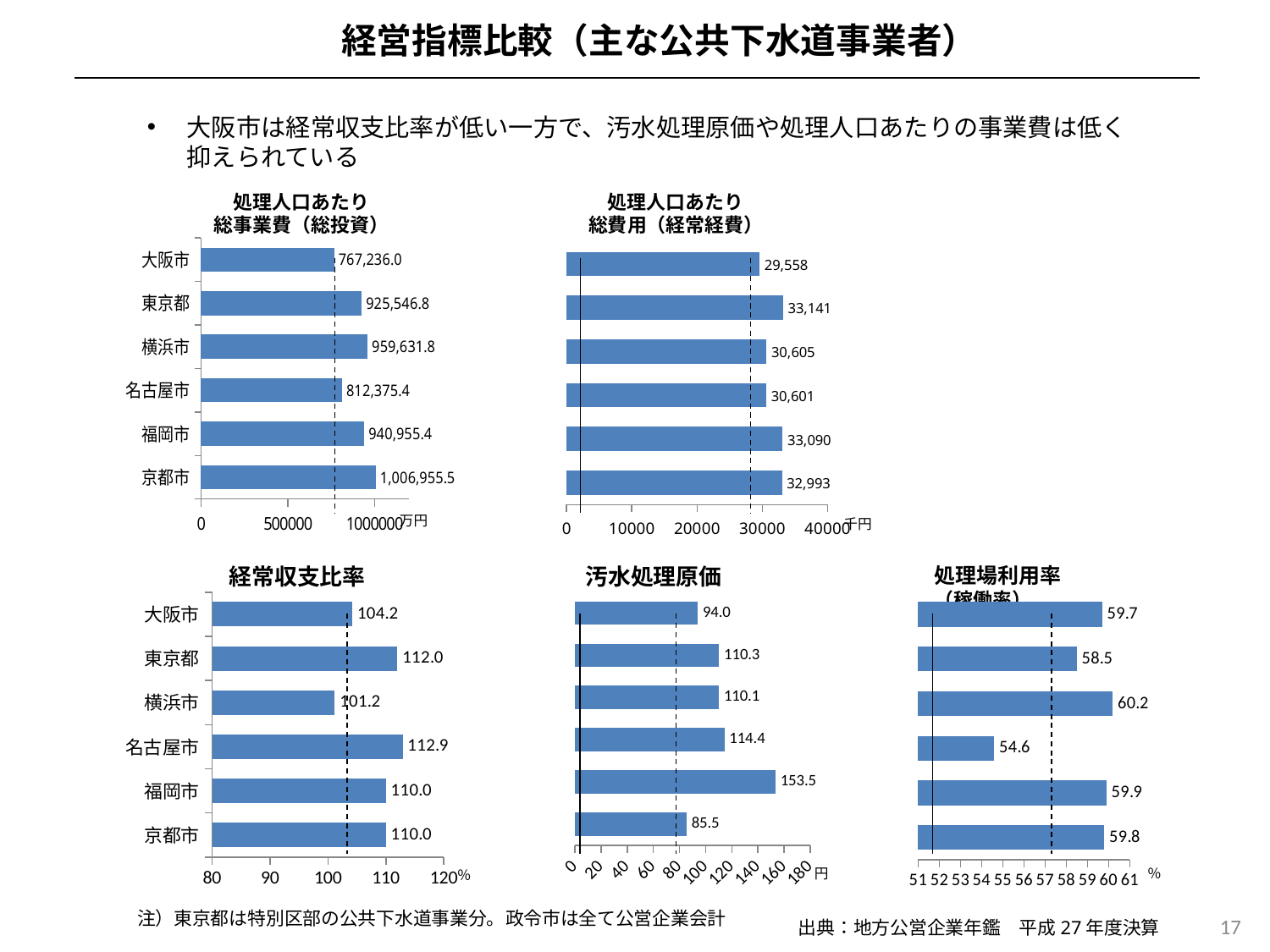
In the 経常収支比率 chart, what is the difference between 東京都 and 大阪市? 7.8 In the 経常収支比率 chart, what is the value for 名古屋市? 112.9 In the 処理人口あたり総事業費（総投資） chart, what is the value for 大阪市? 767,236.0 In the 処理人口あたり総事業費（総投資） chart, which city has the highest value? 京都市 In the 経常収支比率 chart, which city has the lowest value? 横浜市 In the 処理場利用率（稼働率） chart, which city has the lowest value? 名古屋市 In the 処理場利用率（稼働率） chart, is the value for 横浜市 larger or smaller than the value for 東京都? larger In the 汚水処理原価 chart, what is the value for 京都市? 85.5 How many cities are shown in the 経常収支比率 chart? 6 In the 処理人口あたり総費用（経常経費） chart, what is the value for 東京都? 33,141 In the 処理人口あたり総費用（経常経費） chart, which city has the lowest value? 大阪市 In the 汚水処理原価 chart, which city has the highest value? 福岡市